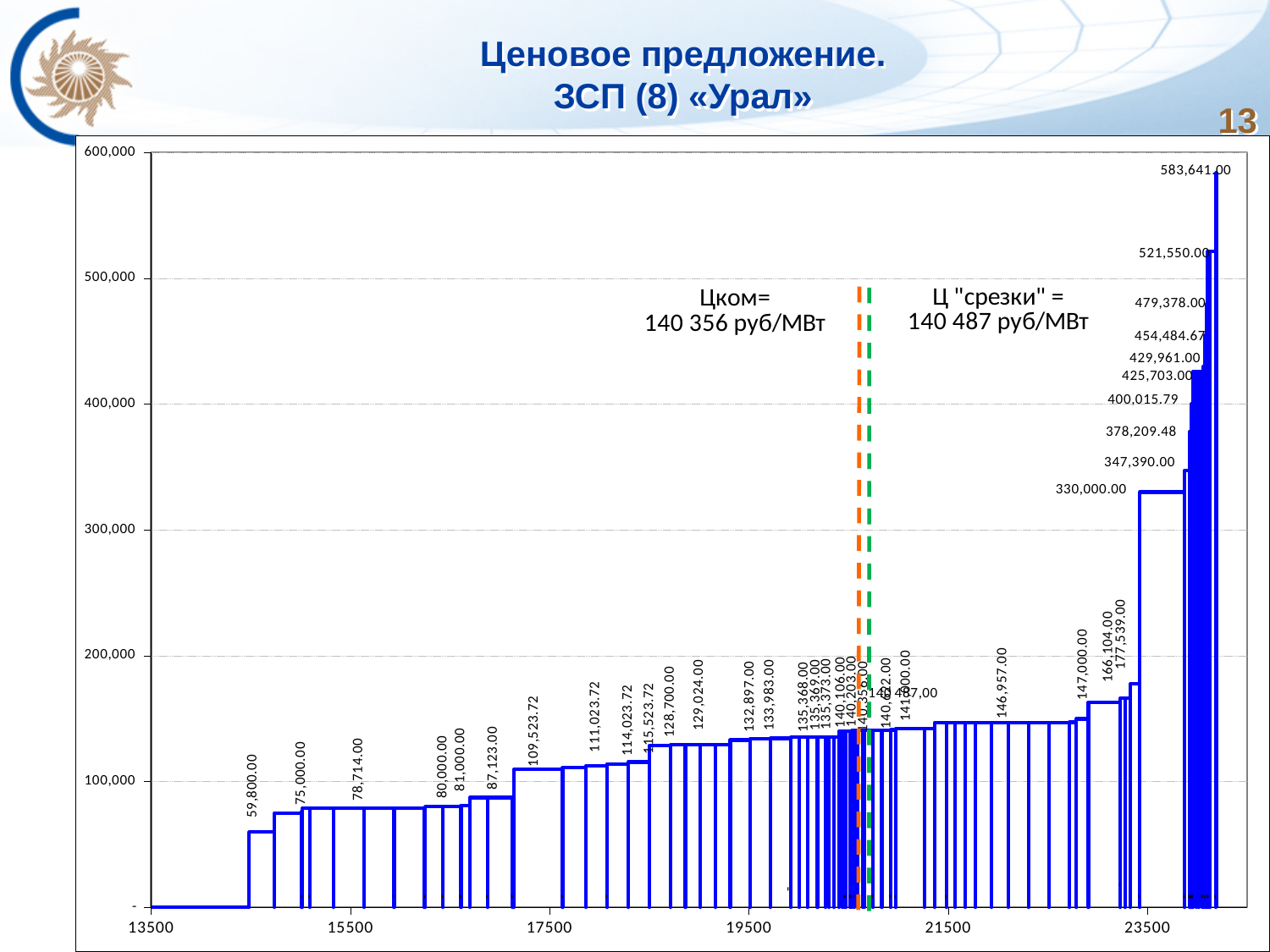
What is the value of Ц "срезки" shown in the annotation on the chart? 140 487 руб/МВт Which labelled value is larger: 146,957.00 or 147,000.00? 147,000.00 What is the value of Цком shown in the annotation on the chart? 140 356 руб/МВт What is the difference between the two highest labelled values, 583,641.00 and 521,550.00? 62,091.00 What is the lowest non-zero price value labelled on the chart? 59,800.00 What is the first labelled value after 87,123.00 on the chart? 109,523.72 Do the price values rise or fall as you move from left to right along the x axis? rise What is the highest price value labelled on the chart? 583,641.00 What is the value of the second-highest labelled step on the chart? 521,550.00 What is the difference between the labelled values 330,000.00 and 177,539.00? 152,461.00 Is the step labelled 330,000.00 above or below the 300,000 gridline? above What is the maximum value shown on the vertical axis? 600,000